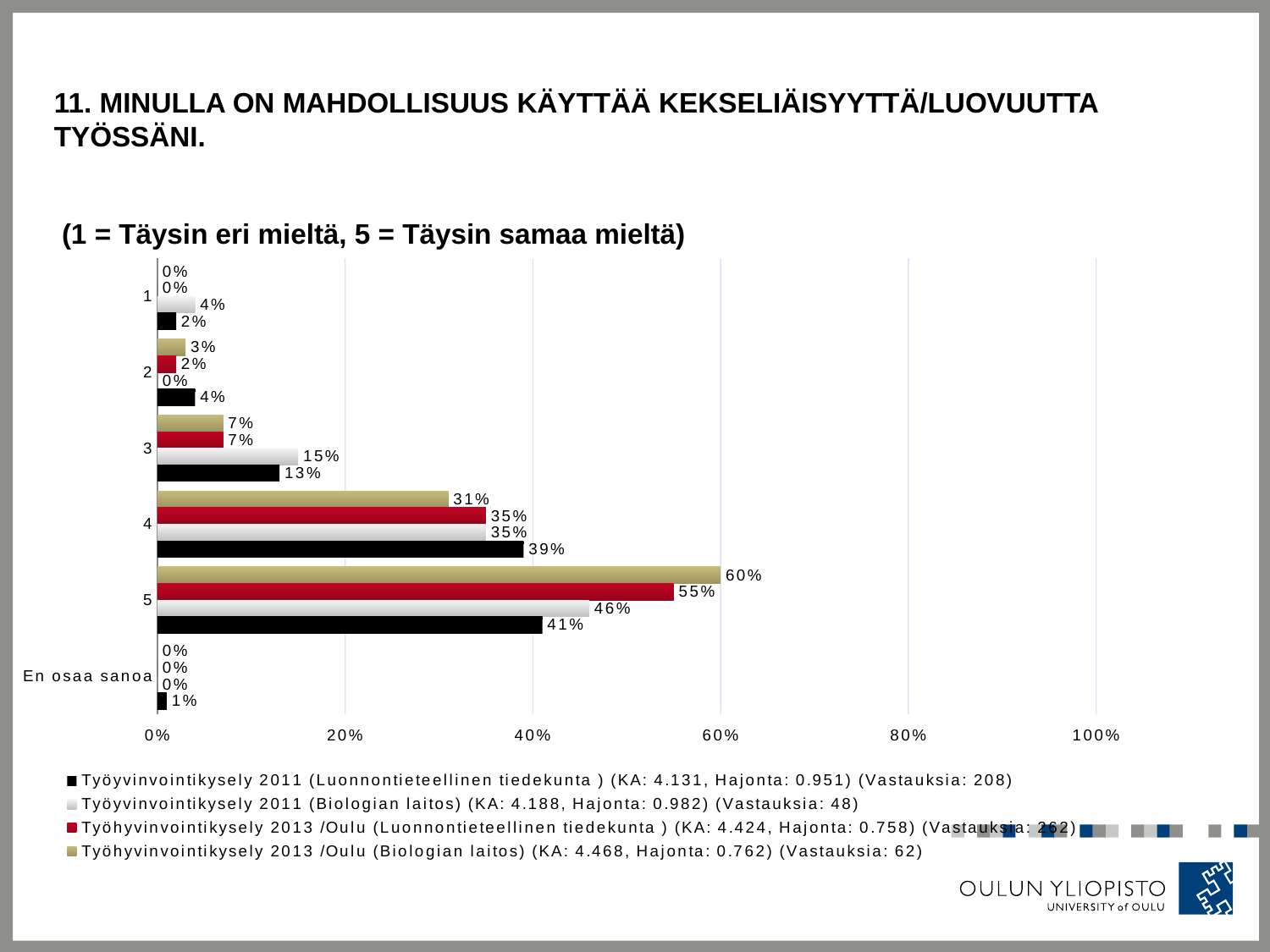
What is the value for 'En osaa sanoa' in the Työyvinvointikysely 2011 (Luonnontieteellinen tiedekunta) series? 1% For category 4, which series has the larger value: Työhyvinvointikysely 2013 /Oulu (Biologian laitos) or Työyvinvointikysely 2011 (Luonnontieteellinen tiedekunta)? Työyvinvointikysely 2011 (Luonnontieteellinen tiedekunta) What is the value for category 5 in the Työhyvinvointikysely 2013 /Oulu (Biologian laitos) series? 60% What kind of chart is shown on the slide? bar chart What is the value for category 3 in the Työyvinvointikysely 2011 (Biologian laitos) series? 15% Is the value for category 5 in the Työhyvinvointikysely 2013 /Oulu (Luonnontieteellinen tiedekunta) series greater or less than 40%? greater Which category has the highest value in the Työhyvinvointikysely 2013 /Oulu (Luonnontieteellinen tiedekunta) series? 5 How many categories are shown on the vertical axis of the chart? 6 How many series does the legend list? 4 Which colour represents the Työhyvinvointikysely 2013 /Oulu (Luonnontieteellinen tiedekunta) series in the legend? red What is the difference between the Työhyvinvointikysely 2013 /Oulu (Biologian laitos) value and the Työyvinvointikysely 2011 (Luonnontieteellinen tiedekunta) value for category 5? 19% What is the value for category 4 in the Työyvinvointikysely 2011 (Luonnontieteellinen tiedekunta) series? 39%